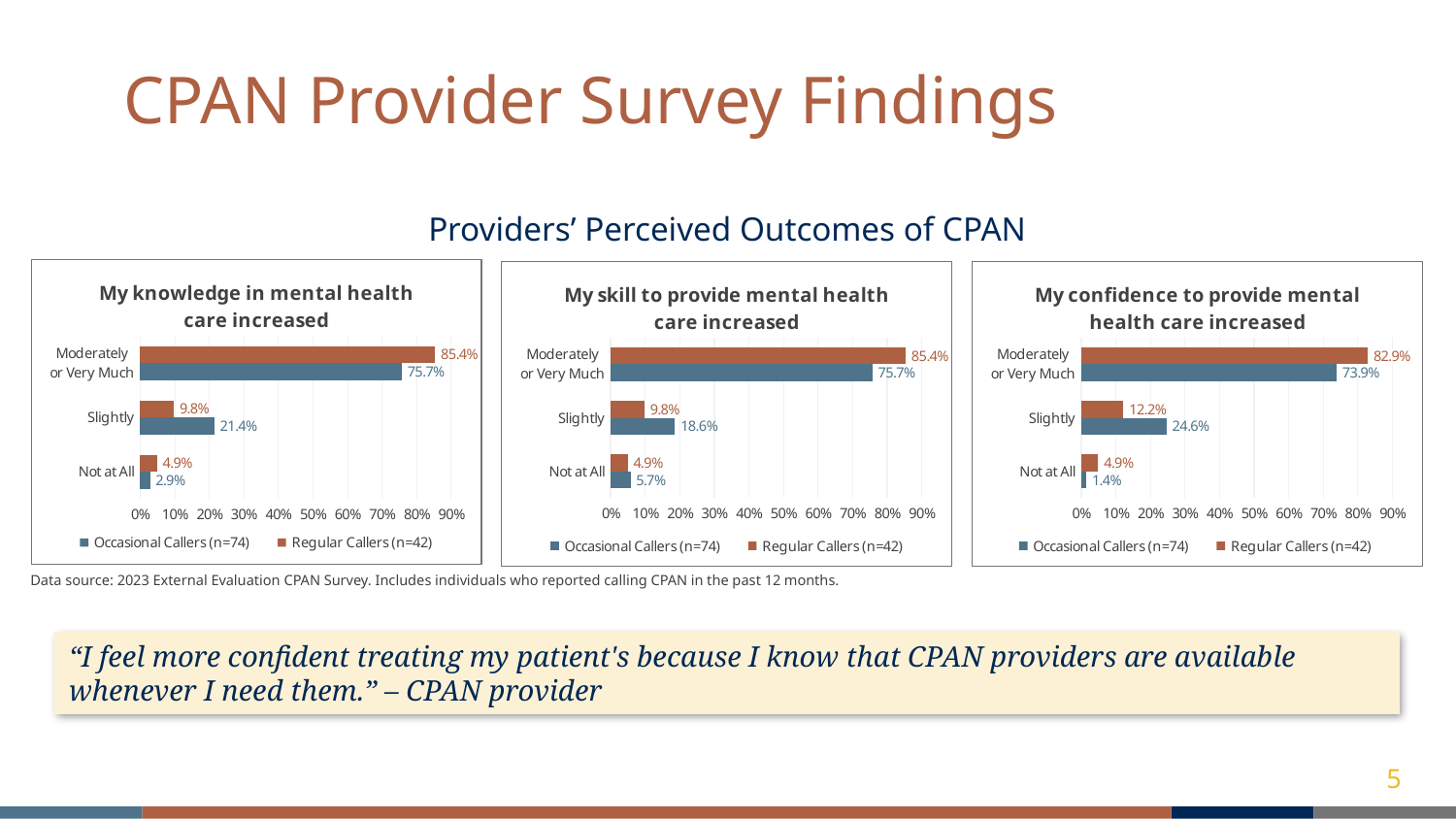
What type of chart is used for "My confidence to provide mental health care increased"? Bar chart In the chart titled "My skill to provide mental health care increased", how many response categories are shown on the y axis? 3 In the chart titled "My knowledge in mental health care increased", what is the value for Occasional Callers in the "Slightly" category? 21.4% In the chart titled "My skill to provide mental health care increased", what colour represents Regular Callers (n=42)? Orange In the chart titled "My knowledge in mental health care increased", what is the difference between the Regular Callers and Occasional Callers values for "Moderately or Very Much"? 9.7% In the chart titled "My knowledge in mental health care increased", how many series does the legend list? 2 In the chart titled "My confidence to provide mental health care increased", which category has the lowest value for Occasional Callers? Not at All In the chart titled "My skill to provide mental health care increased", which category has the highest value for Regular Callers? Moderately or Very Much In the chart titled "My confidence to provide mental health care increased", what is the value for Regular Callers in the "Slightly" category? 12.2% In the chart titled "My knowledge in mental health care increased", what is the value for Regular Callers in the "Moderately or Very Much" category? 85.4% In the chart titled "My confidence to provide mental health care increased", which is larger for the "Slightly" category: Occasional Callers or Regular Callers? Occasional Callers In the chart titled "My skill to provide mental health care increased", what is the value for Occasional Callers in the "Not at All" category? 5.7%